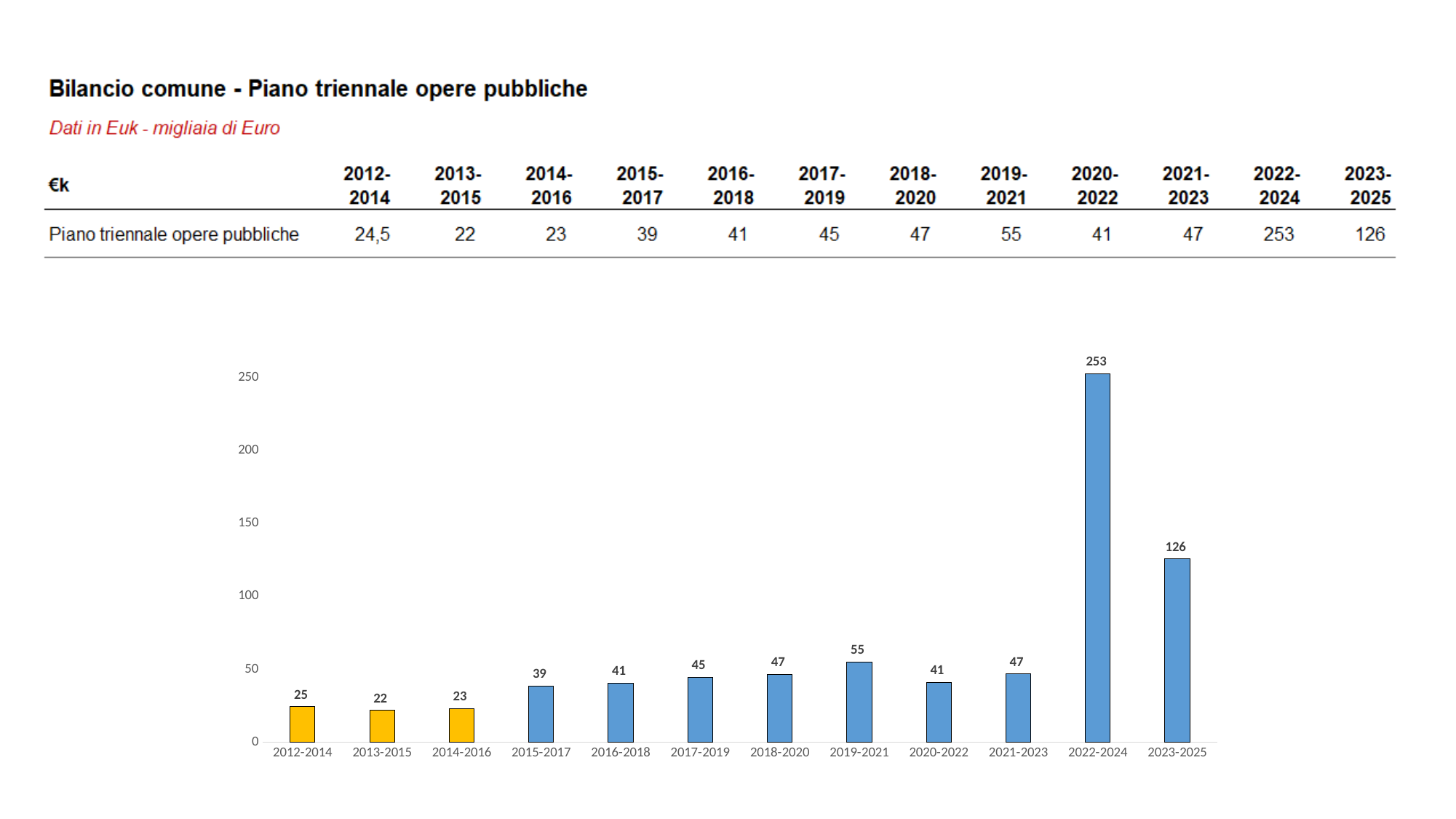
How many bars (periods) does the chart show? 12 Which period has the lowest value in the chart? 2013-2015 Which bars in the chart are coloured yellow/orange rather than blue? 2012-2014, 2013-2015 and 2014-2016 Which is larger in the chart, the value for 2015-2017 or the value for 2020-2022? 2020-2022 What is the difference between the values for 2022-2024 and 2023-2025 in the chart? 127 What is the value shown for 2022-2024 in the chart? 253 Is the value for 2023-2025 greater or less than 100? greater What type of chart is shown on the slide? bar chart What is the value shown for 2023-2025 in the chart? 126 What is the title of the slide above the chart? Bilancio comune - Piano triennale opere pubbliche Which period has the highest value in the chart? 2022-2024 What is the value shown for 2019-2021 in the chart? 55